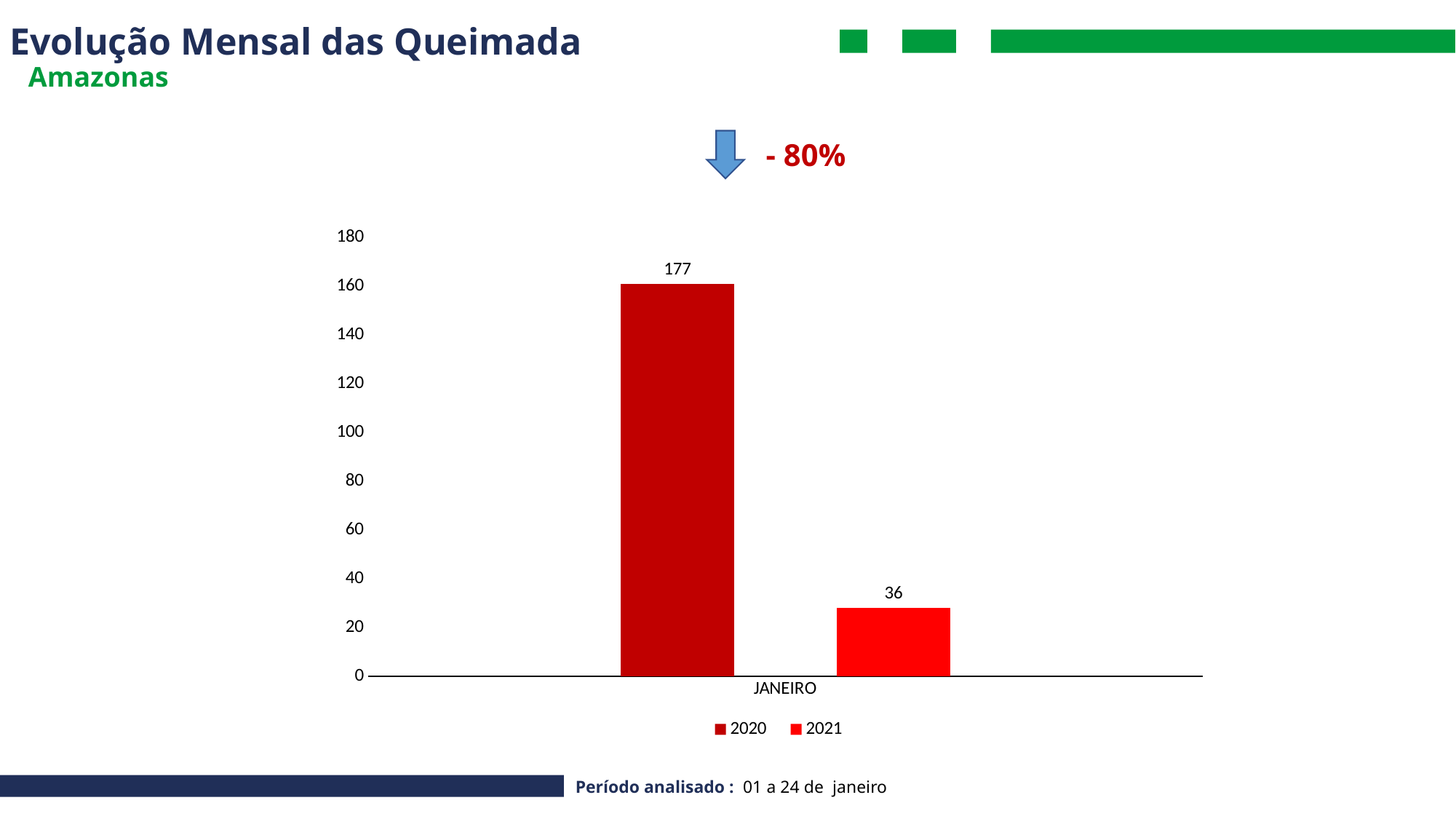
How many series does the legend list? 2 Which series has the lowest value in JANEIRO? 2021 Which series has the higher value in JANEIRO, 2020 or 2021? 2020 What is the name of the category on the x axis? JANEIRO How many categories are shown on the x axis? 1 What is the value for 2020 in JANEIRO? 177 What is the difference between the 2020 and 2021 values for JANEIRO? 141 What kind of chart is shown on the slide? bar chart Is the value for 2021 in JANEIRO greater or less than 40? less What is the value for 2021 in JANEIRO? 36 Is the value for 2020 in JANEIRO greater or less than 160? greater What percentage change is shown above the chart? - 80%